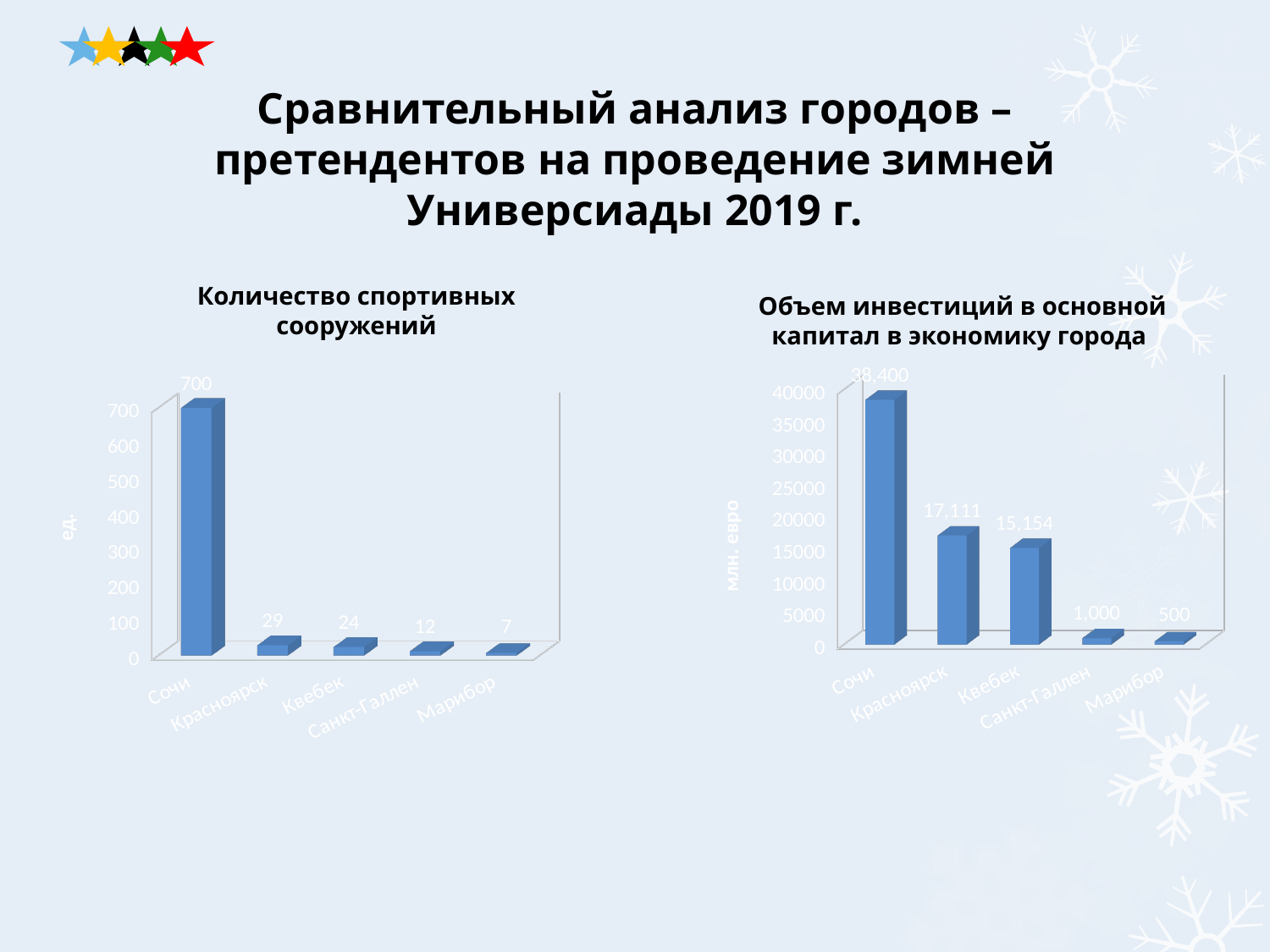
What is the y-axis label of the chart "Объем инвестиций в основной капитал в экономику города"? млн. евро In the chart "Объем инвестиций в основной капитал в экономику города", which is larger, Квебек or Санкт-Галлен? Квебек What type of chart is "Объем инвестиций в основной капитал в экономику города"? Bar chart In the chart "Объем инвестиций в основной капитал в экономику города", what is the value for Марибор? 500 In the chart "Количество спортивных сооружений", what is the difference between Красноярск and Санкт-Галлен? 17 In the chart "Количество спортивных сооружений", what is the value for Сочи? 700 In the chart "Объем инвестиций в основной капитал в экономику города", which city has the highest value? Сочи In the chart "Количество спортивных сооружений", how many cities are shown on the x axis? 5 In the chart "Объем инвестиций в основной капитал в экономику города", what is the difference between Сочи and Красноярск? 21,289 In the chart "Количество спортивных сооружений", what is the value for Квебек? 24 In the chart "Количество спортивных сооружений", which city has the lowest value? Марибор In the chart "Объем инвестиций в основной капитал в экономику города", what is the value for Красноярск? 17,111